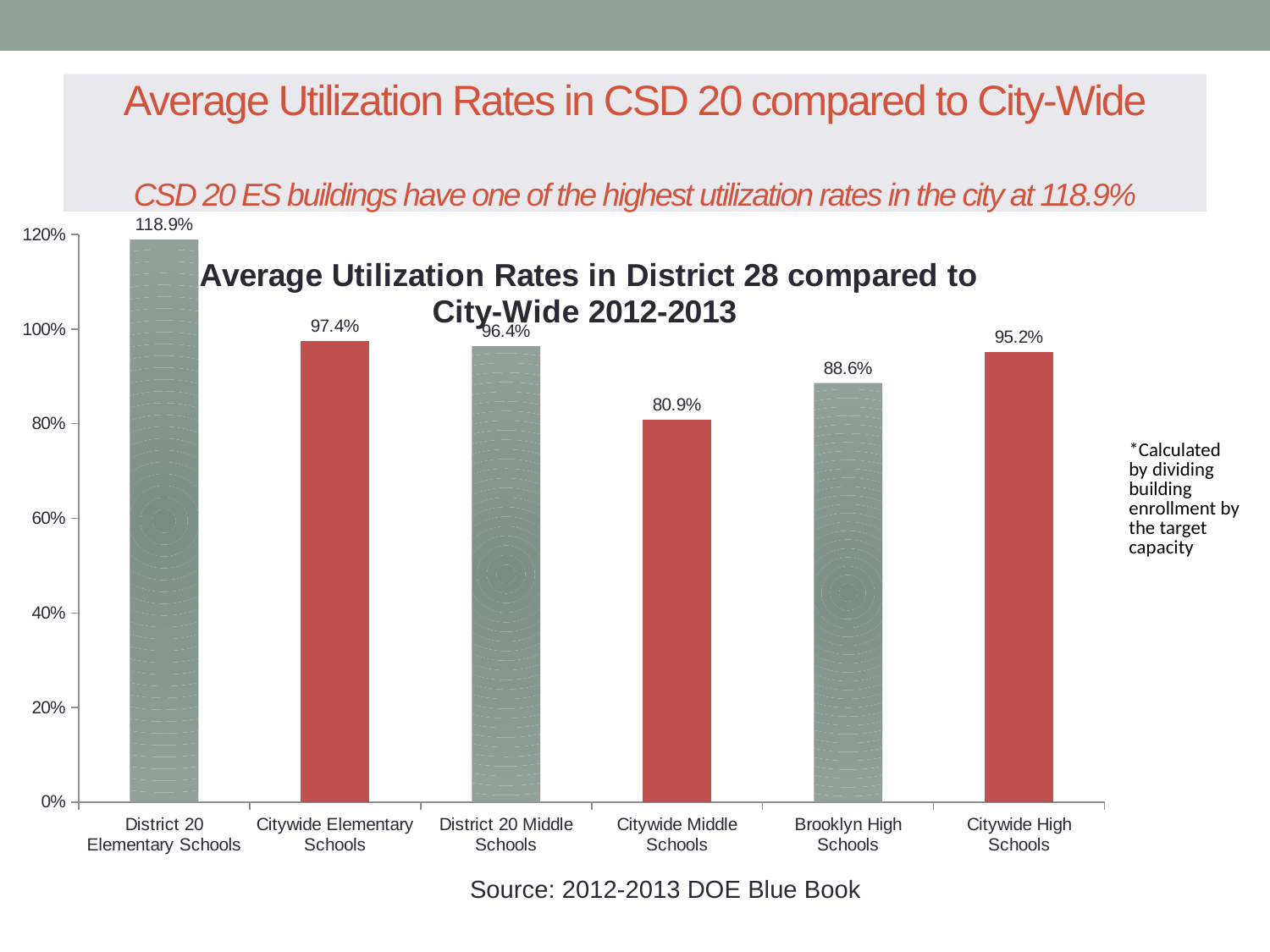
What is the difference between the utilization rates of District 20 Middle Schools and Citywide Middle Schools? 15.5% What is the average utilization rate for Citywide High Schools? 95.2% Which category has the highest utilization rate? District 20 Elementary Schools What is the average utilization rate for Citywide Middle Schools? 80.9% What is the difference between the utilization rates of District 20 Elementary Schools and Citywide Elementary Schools? 21.5% Which category has the lowest utilization rate? Citywide Middle Schools What is the average utilization rate for District 20 Elementary Schools? 118.9% What is the title printed inside the chart area? Average Utilization Rates in District 28 compared to City-Wide 2012-2013 How many categories are shown on the x axis of the chart? 6 What type of chart is shown on the slide? Bar chart Which has a higher utilization rate, Brooklyn High Schools or Citywide High Schools? Citywide High Schools What is the average utilization rate for Brooklyn High Schools? 88.6%